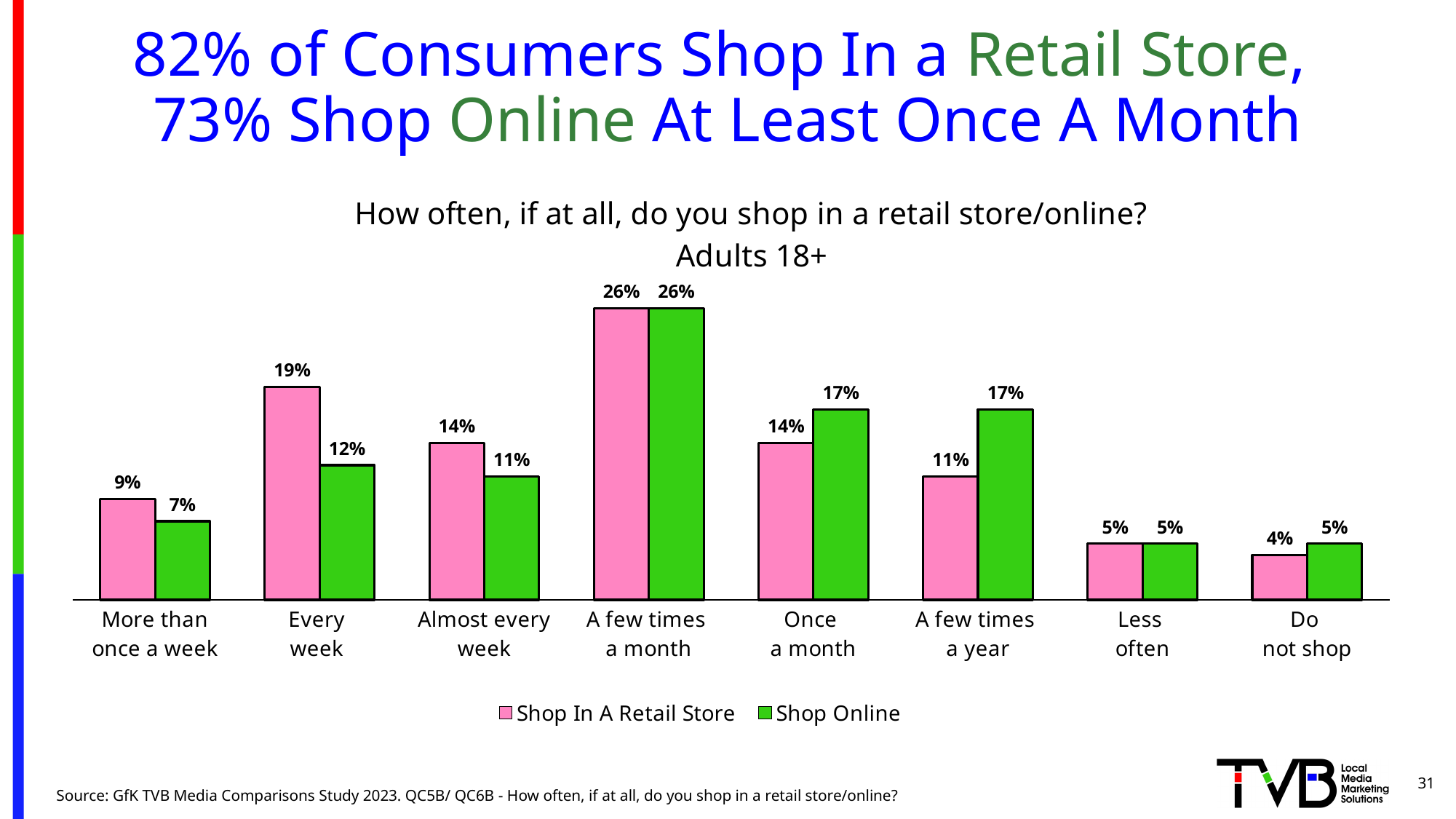
What is the difference between Shop In A Retail Store and Shop Online for 'Almost every week'? 3% Which category has the highest value for Shop In A Retail Store? A few times a month What is the difference between Shop In A Retail Store and Shop Online for the 'Every week' category? 7% What kind of chart is shown on the slide? Bar chart Which category has the lowest value for Shop In A Retail Store? Do not shop How many series does the legend list? 2 What percentage of adults shop in a retail store every week? 19% What colour represents the Shop Online series? Green What is the value for Shop Online in the 'More than once a week' category? 7% How many frequency categories are shown on the x axis? 8 In the 'Once a month' category, which is larger: Shop In A Retail Store or Shop Online? Shop Online What percentage of adults shop online a few times a year? 17%